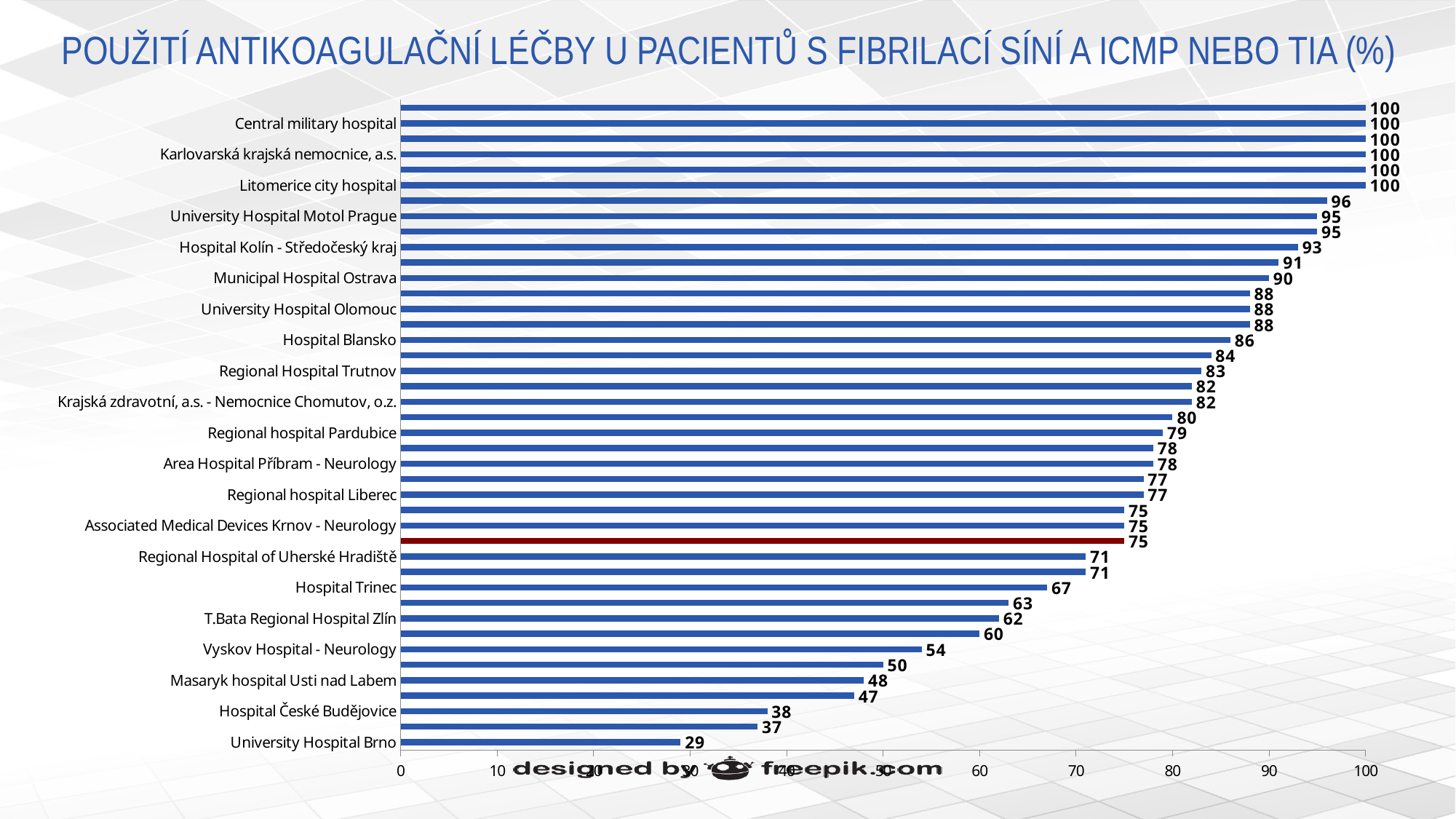
Which is larger, the value for Regional hospital Pardubice or the value for T.Bata Regional Hospital Zlín? Regional hospital Pardubice Is the value for Masaryk hospital Usti nad Labem greater or less than 50? less What is the value for Hospital Trinec? 67 What is the value of the bar highlighted in dark red? 75 What is the difference between the values for Hospital Blansko and Hospital České Budějovice? 48 What is the value for University Hospital Brno? 29 Which labeled hospital has the lowest value? University Hospital Brno What is the value for Vyskov Hospital - Neurology? 54 What is the highest value shown on the chart? 100 What kind of chart is shown on the slide? bar chart What is the value for Municipal Hospital Ostrava? 90 Do the values increase or decrease going from the top of the chart to the bottom? decrease